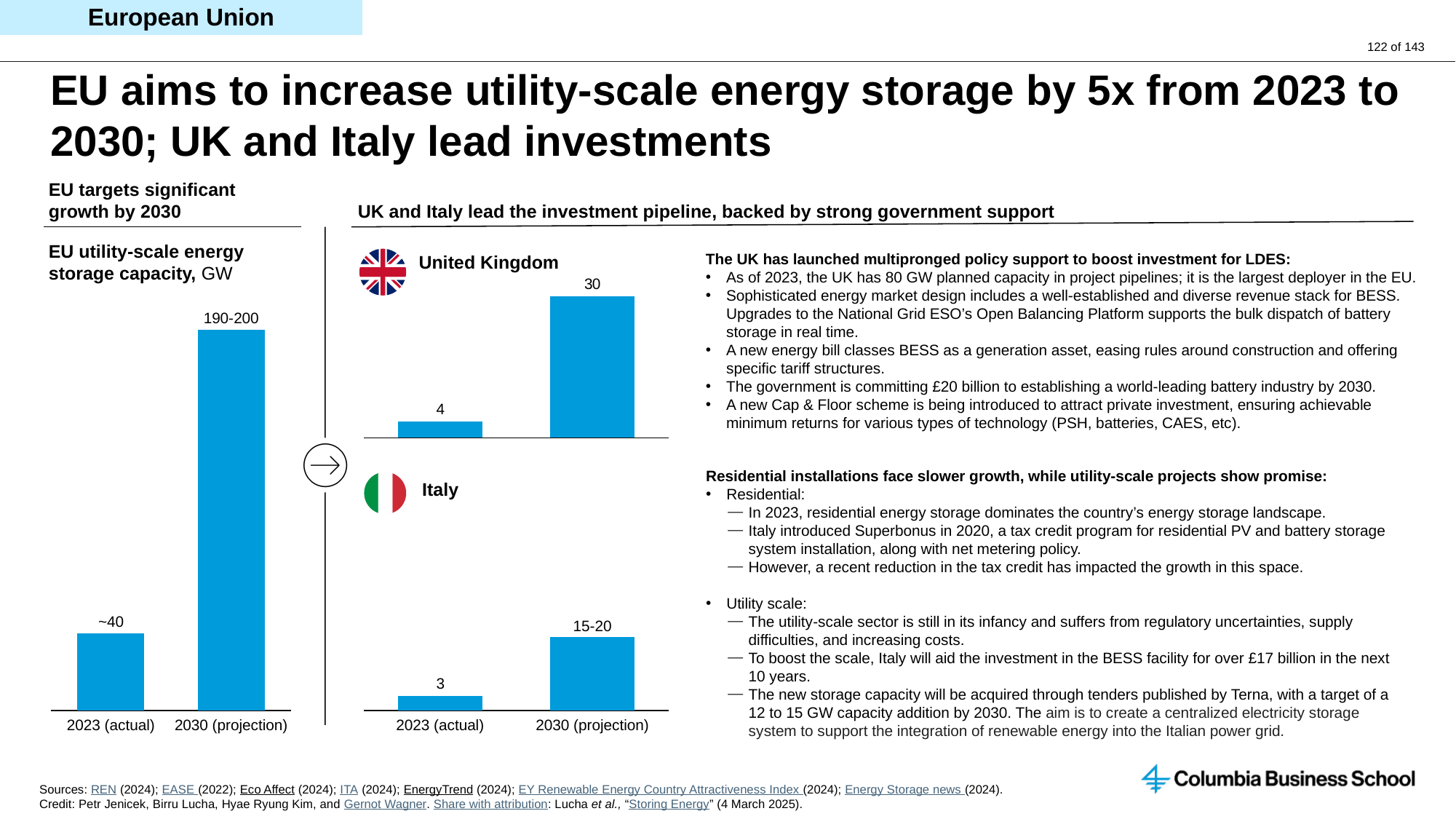
In the Italy chart, which category has the lowest value? 2023 (actual) In the EU utility-scale energy storage capacity chart, which is larger: 2023 (actual) or 2030 (projection)? 2030 (projection) In the United Kingdom chart, which category has the highest value? 2030 (projection) In the United Kingdom chart, what is the value for 2023 (actual)? 4 How many categories are shown in the United Kingdom chart? 2 In the United Kingdom chart, what is the value for 2030 (projection)? 30 In the EU utility-scale energy storage capacity chart, what is the value for 2030 (projection)? 190-200 In the United Kingdom chart, what is the difference between the 2030 (projection) and 2023 (actual) values? 26 What type of chart is the Italy chart? bar chart In the Italy chart, what is the value for 2023 (actual)? 3 In the Italy chart, what is the value for 2030 (projection)? 15-20 What unit is given in the title of the EU utility-scale energy storage capacity chart? GW